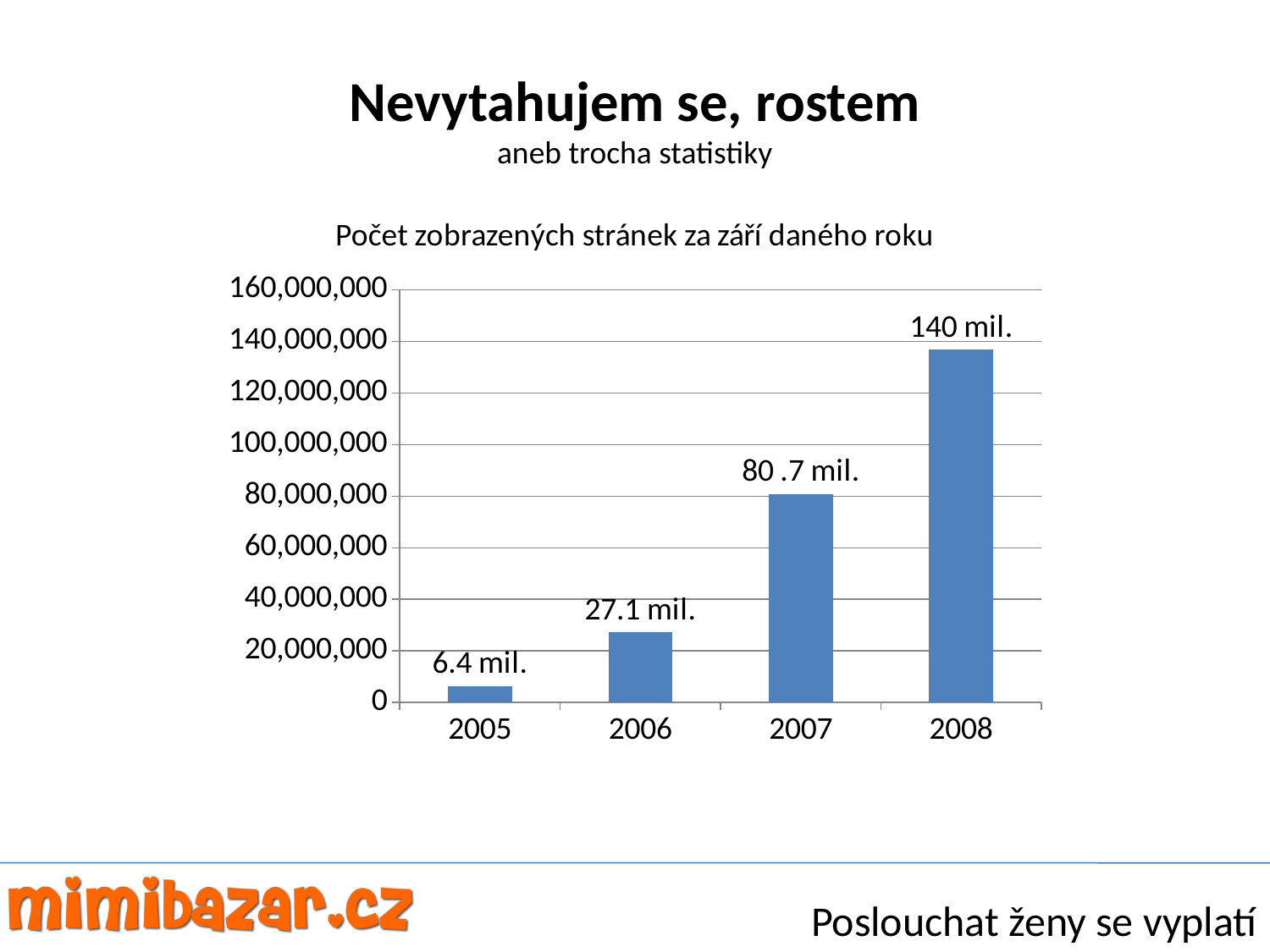
Which year has the highest value? 2008 Is the value for 2006 greater or less than 20,000,000? greater What is the value shown for 2008? 140 mil. What is the value shown for 2005? 6.4 mil. How many years are shown on the x axis? 4 What is the value shown for 2007? 80 .7 mil. Which is larger, the value for 2006 or the value for 2007? 2007 Do the values rise or fall from 2005 to 2008? rise What kind of chart is shown? bar chart What is the title of the chart? Počet zobrazených stránek za září daného roku Which year has the lowest value? 2005 What is the value shown for 2006? 27.1 mil.